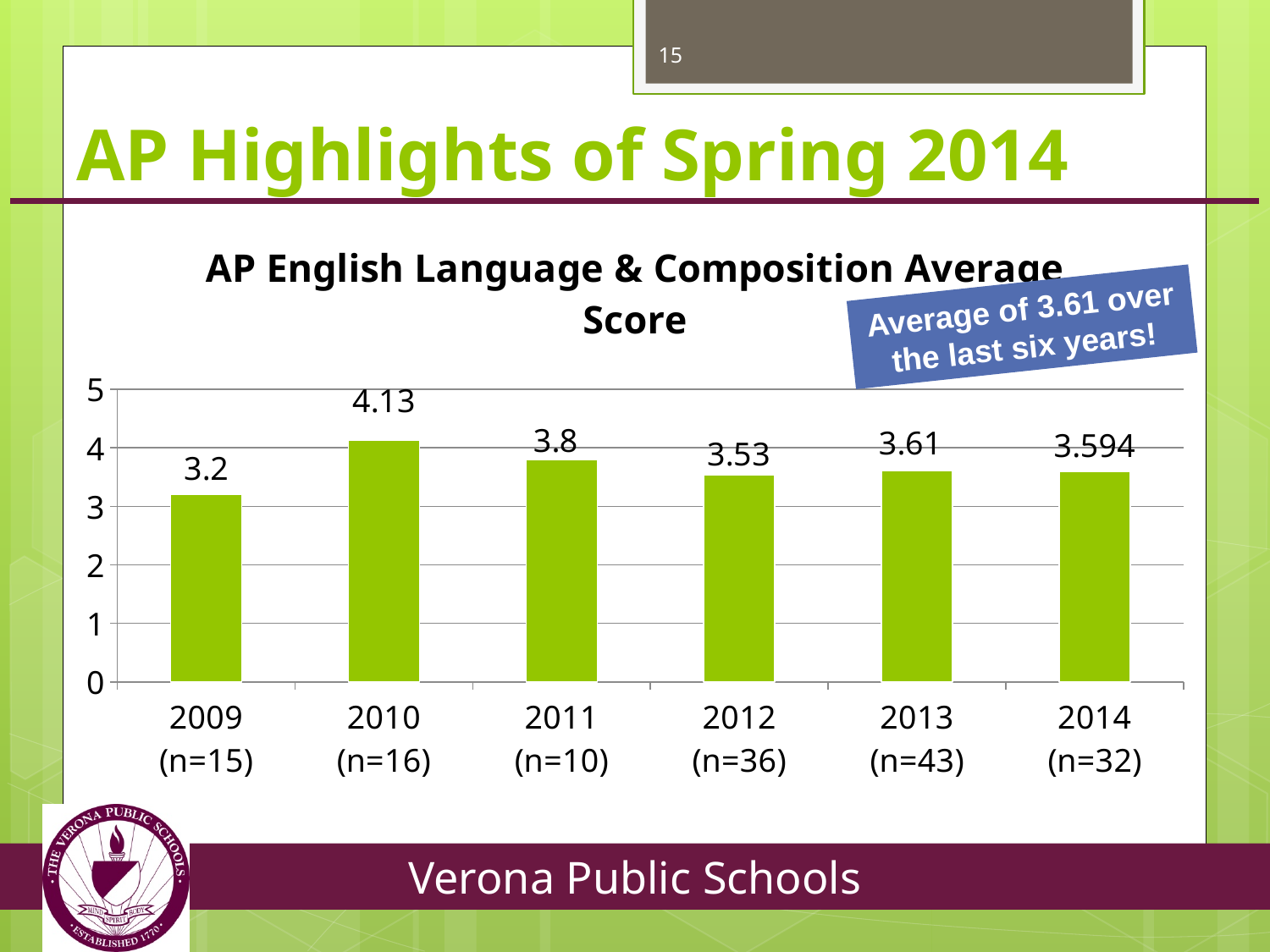
Which year has a higher average score, 2011 or 2013? 2011 (n=10) Which year has the highest average score? 2010 (n=16) What is the difference between the average scores for 2010 and 2009? 0.93 How many years are shown on the x axis of the chart? 6 According to the callout on the slide, what is the average score over the last six years? 3.61 What is the difference between the average scores for 2011 and 2012? 0.27 What is the average score shown for 2014 (n=32)? 3.594 What is the average AP English Language & Composition score for 2010 (n=16)? 4.13 Which year has the lowest average score? 2009 (n=15) Is the average score for 2009 greater or less than 4? less What is the average score shown for 2012 (n=36)? 3.53 What kind of chart is used to show the AP English Language & Composition average scores? Bar chart